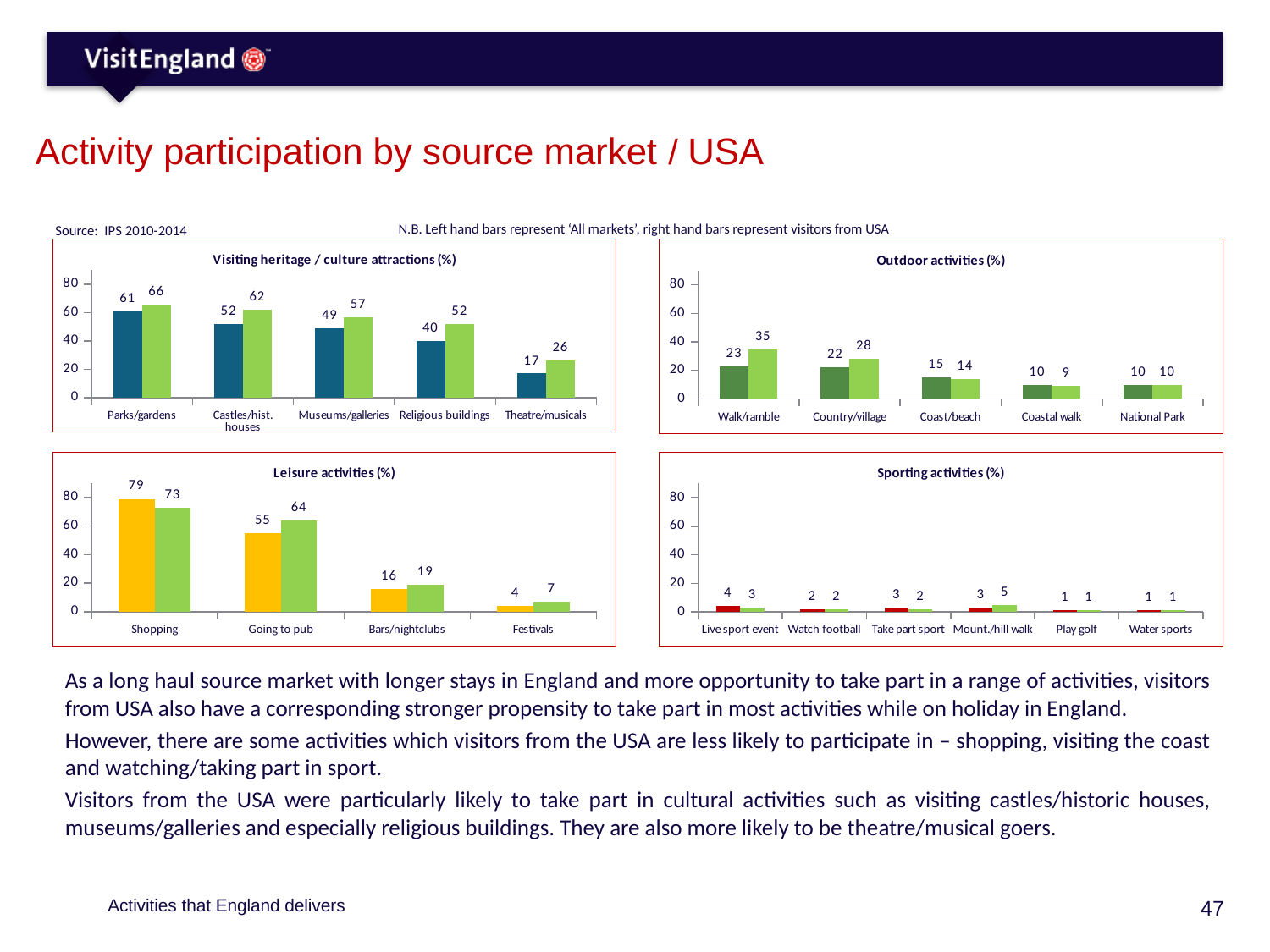
In the 'Leisure activities (%)' chart, which is larger for Going to pub: the All markets bar or the USA bar? USA bar In the 'Visiting heritage / culture attractions (%)' chart, which category has the highest value for the right-hand (USA) bar? Parks/gardens In the 'Visiting heritage / culture attractions (%)' chart, what is the difference between the USA bar and the All markets bar for Religious buildings? 12 In the 'Visiting heritage / culture attractions (%)' chart, what is the value of the left-hand (All markets) bar for Theatre/musicals? 17 In the 'Outdoor activities (%)' chart, what is the value of the right-hand (USA) bar for Walk/ramble? 35 In the 'Sporting activities (%)' chart, what is the value of the right-hand (USA) bar for Mount./hill walk? 5 In the 'Visiting heritage / culture attractions (%)' chart, what is the value of the right-hand (USA) bar for Religious buildings? 52 In the 'Sporting activities (%)' chart, how many categories are shown on the x axis? 6 What type of chart is the 'Outdoor activities (%)' chart? Bar chart In the 'Leisure activities (%)' chart, what is the value of the left-hand (All markets) bar for Shopping? 79 In the 'Outdoor activities (%)' chart, which category has the lowest value for the left-hand (All markets) bar? Coastal walk and National Park (both 10) In the 'Leisure activities (%)' chart, how many categories are shown on the x axis? 4